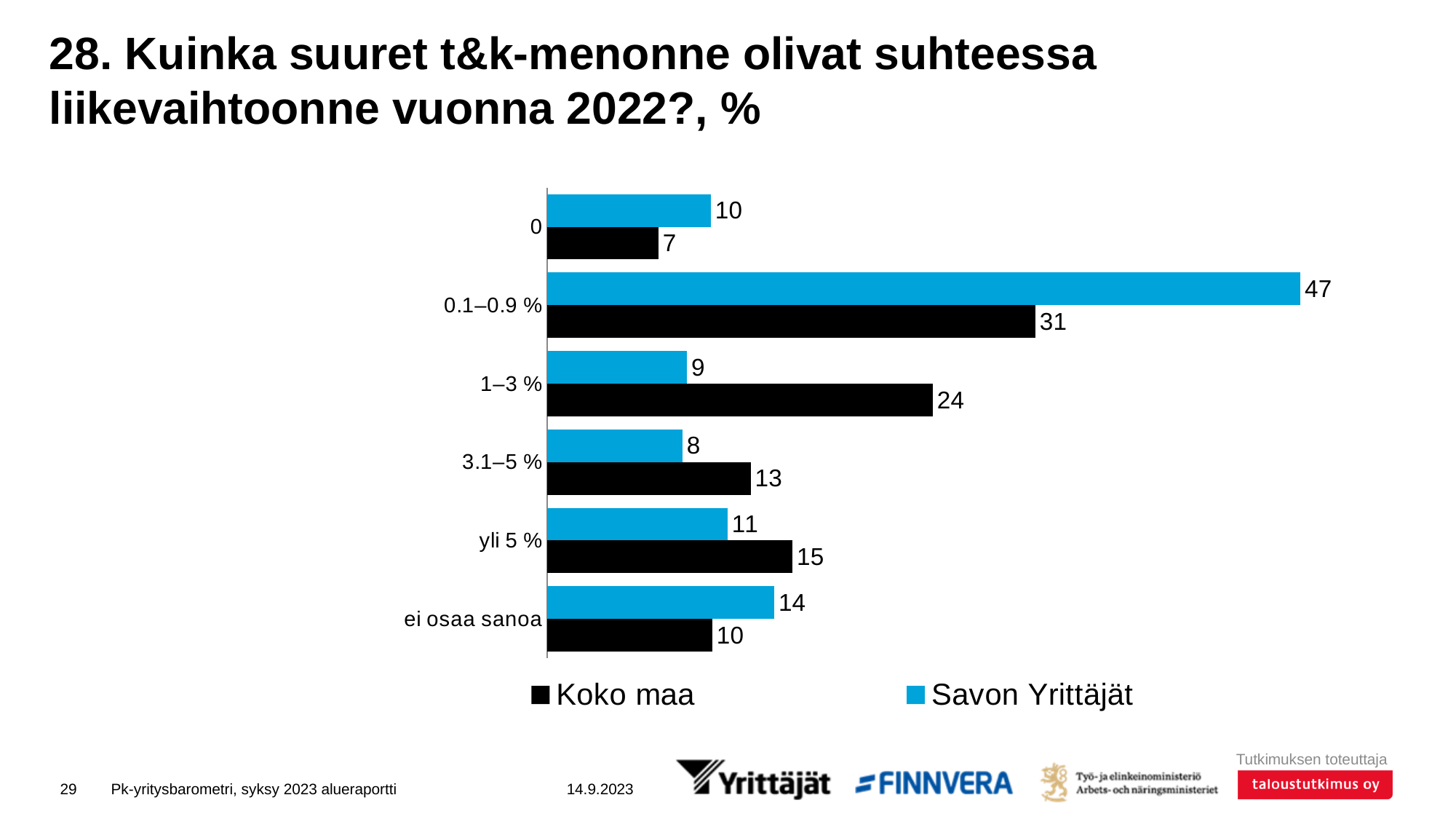
Which colour represents Savon Yrittäjät in the chart? Blue What is the value for Koko maa in the 1–3 % category? 24 Which is larger in the 1–3 % category: Koko maa or Savon Yrittäjät? Koko maa How many series does the legend list? 2 What is the difference between Savon Yrittäjät and Koko maa in the 0.1–0.9 % category? 16 What kind of chart is shown on the slide? Bar chart What is the value for Savon Yrittäjät in the 0.1–0.9 % category? 47 Which category has the lowest value for Koko maa? 0 How many categories are shown on the chart? 6 What is the value for Koko maa in the 'ei osaa sanoa' category? 10 Which is larger in the 0 category: Koko maa or Savon Yrittäjät? Savon Yrittäjät Which category has the highest value for Savon Yrittäjät? 0.1–0.9 %